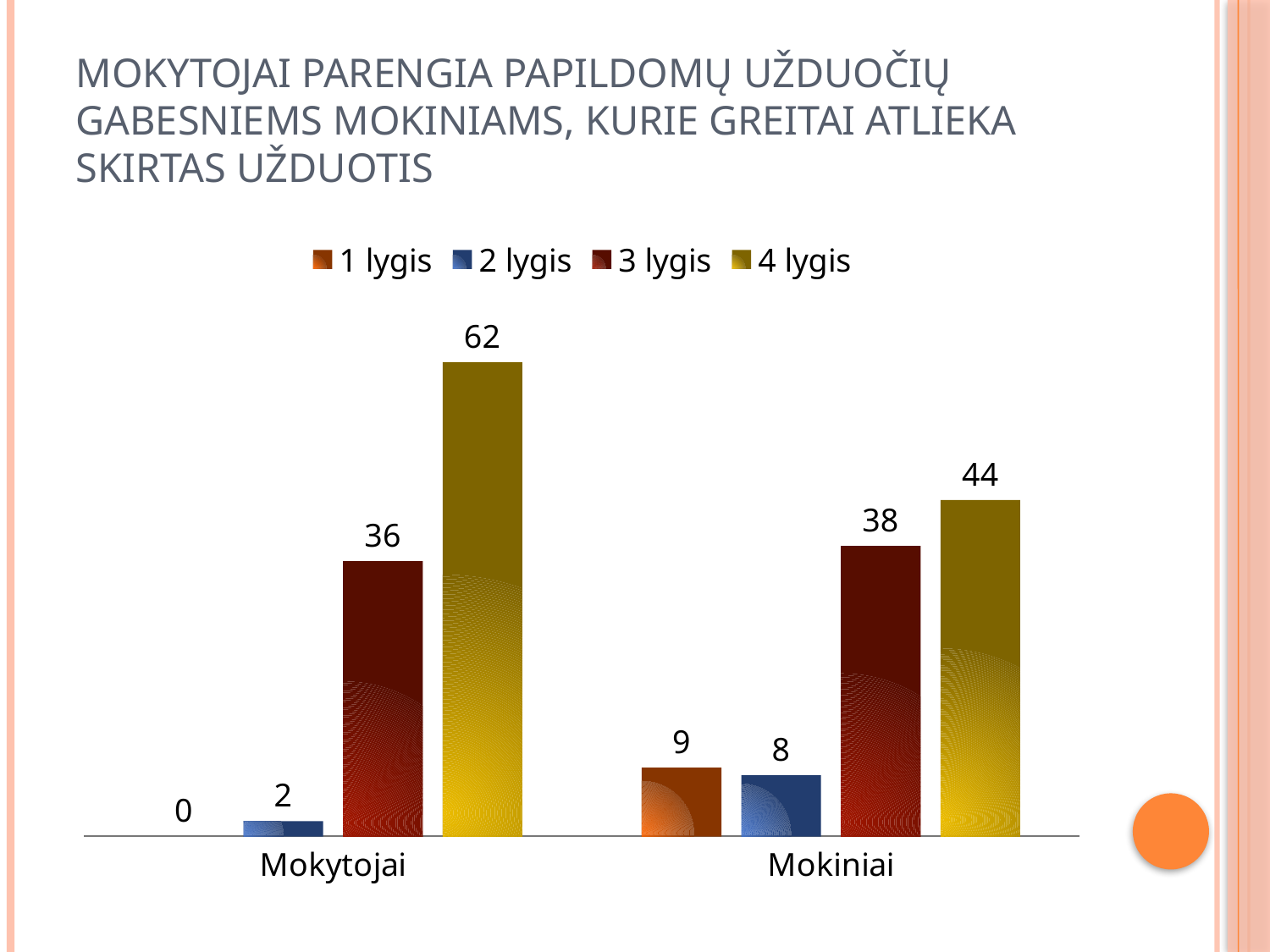
What is the value for 3 lygis in the Mokiniai category? 38 What is the value for 4 lygis in the Mokytojai category? 62 Which is larger: the 3 lygis value for Mokytojai or for Mokiniai? Mokiniai Which series has the lowest value in the Mokytojai category? 1 lygis What is the difference between the 4 lygis values for Mokytojai and Mokiniai? 18 Which series has the highest value in the Mokiniai category? 4 lygis What is the total of the four series values for the Mokiniai category? 99 What kind of chart is shown on the slide? Bar chart What is the value for 1 lygis in the Mokytojai category? 0 How many categories are shown on the x axis? 2 What is the value for 2 lygis in the Mokiniai category? 8 How many series does the legend list? 4